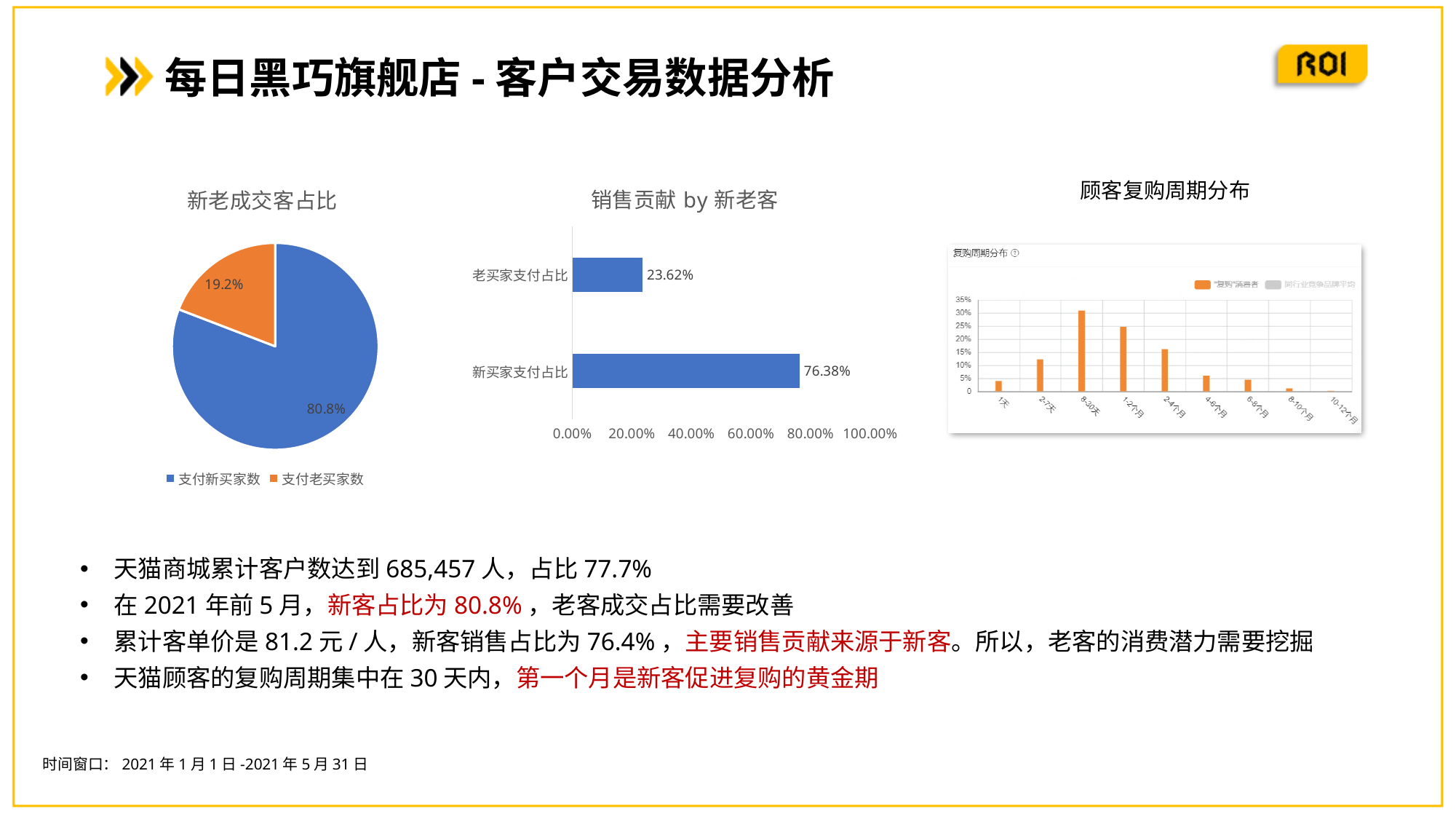
In the chart 顾客复购周期分布, is the value for 8-30天 greater or less than 25%? greater In the chart 销售贡献 by 新老客, what is the highest value shown on the horizontal axis? 100.00% In the chart 顾客复购周期分布, which category has the highest bar? 8-30天 In the pie chart 新老成交客占比, what share is labelled for 支付老买家数? 19.2% In the pie chart 新老成交客占比, which slice is larger, 支付新买家数 or 支付老买家数? 支付新买家数 In the chart 销售贡献 by 新老客, what is the value for 新买家支付占比? 76.38% What kind of chart is 销售贡献 by 新老客? bar chart In the pie chart 新老成交客占比, how many entries does the legend list? 2 In the pie chart 新老成交客占比, what share is labelled for 支付新买家数? 80.8% In the chart 销售贡献 by 新老客, what is the difference between 新买家支付占比 and 老买家支付占比? 52.76% In the chart 顾客复购周期分布, how many categories are shown on the x axis? 9 In the chart 销售贡献 by 新老客, what is the value for 老买家支付占比? 23.62%